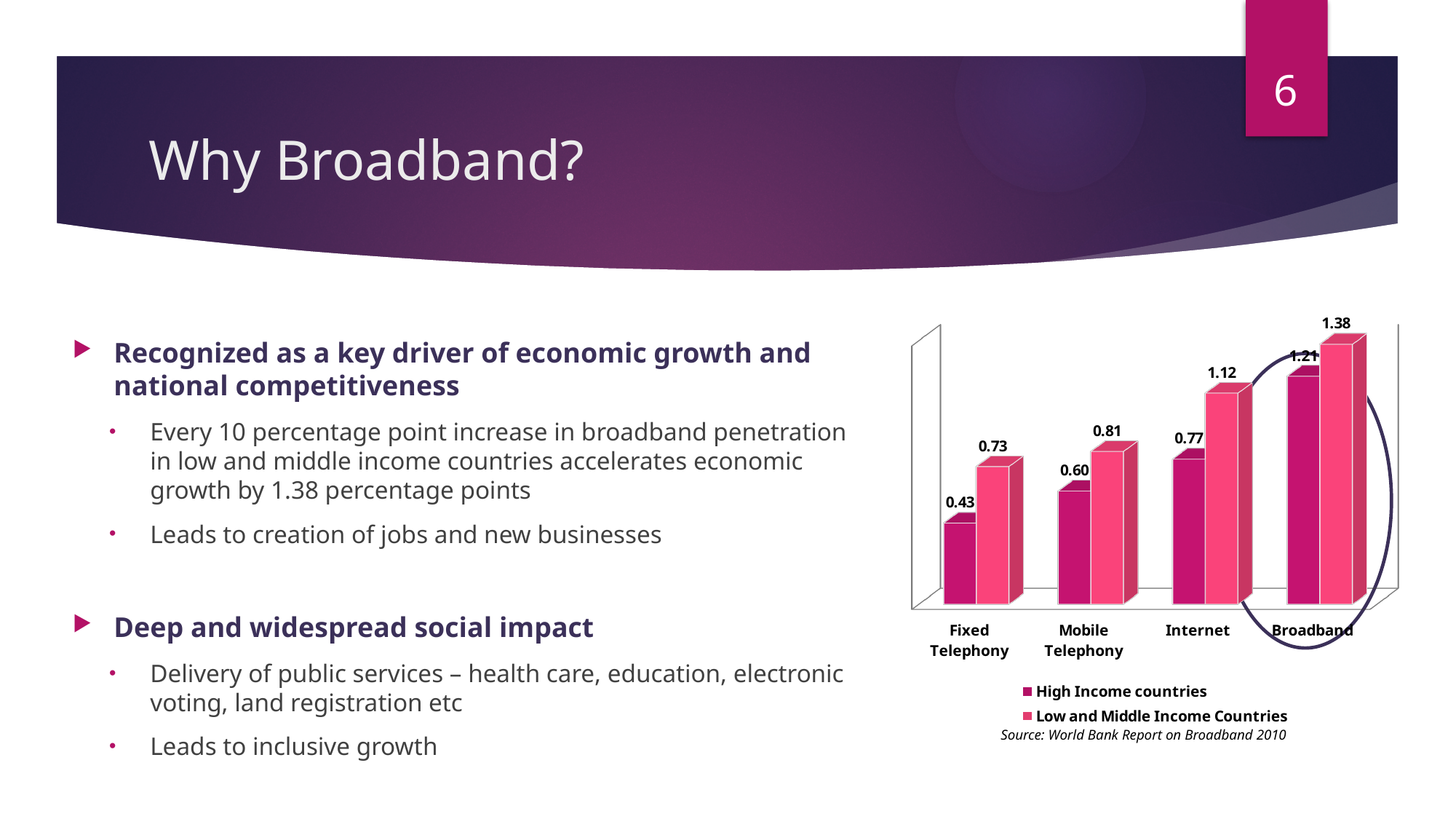
What is the value for Low and Middle Income Countries for Mobile Telephony? 0.81 Which is larger for Internet: the High Income countries value or the Low and Middle Income Countries value? Low and Middle Income Countries How many series does the chart's legend list? 2 What is the value for High Income countries for Internet? 0.77 What is the value for Low and Middle Income Countries for Broadband? 1.38 Which category has the highest value for Low and Middle Income Countries? Broadband Which category has the lowest value for High Income countries? Fixed Telephony Do the High Income countries values rise or fall from Fixed Telephony to Broadband? Rise What kind of chart is shown on the slide? Bar chart What is the value for High Income countries for Fixed Telephony? 0.43 How many categories are shown on the x axis of the chart? 4 What is the difference between the Low and Middle Income Countries value and the High Income countries value for Broadband? 0.17